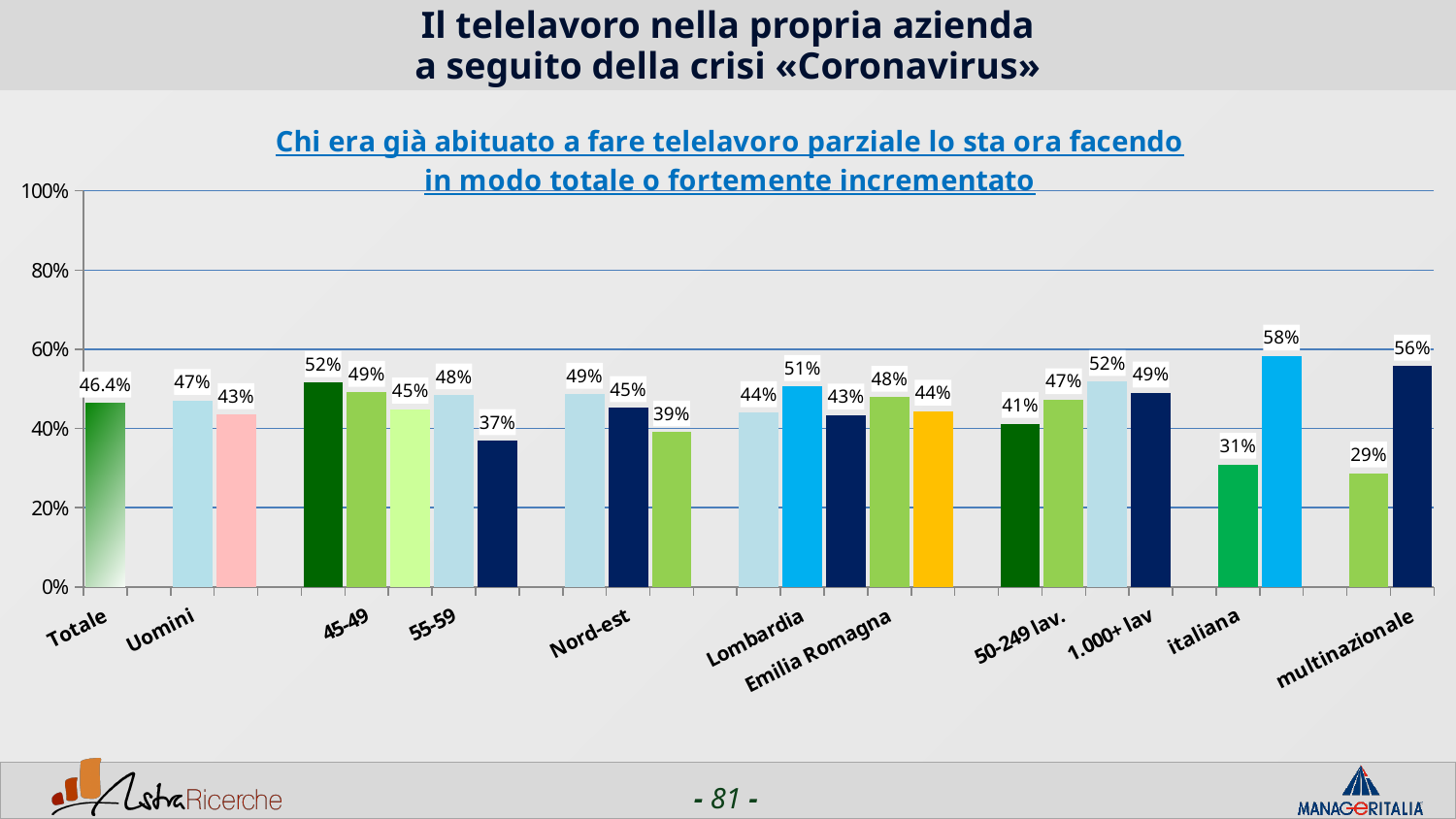
What is the value for Totale? 46.4% What is the value for italiana? 31% What is the value for Uomini? 47% What is the title of the slide? Il telelavoro nella propria azienda a seguito della crisi «Coronavirus» Is the value for Totale greater or less than 40%? greater What is the value for multinazionale? 56% What kind of chart is shown on the slide? Bar chart What is the difference between the values for multinazionale and italiana? 25 percentage points What is the value for Lombardia? 51% What is the value for 1.000+ lav? 49% What is the value for Nord-est? 45% Which is larger, the value for Lombardia or the value for Emilia Romagna? Lombardia